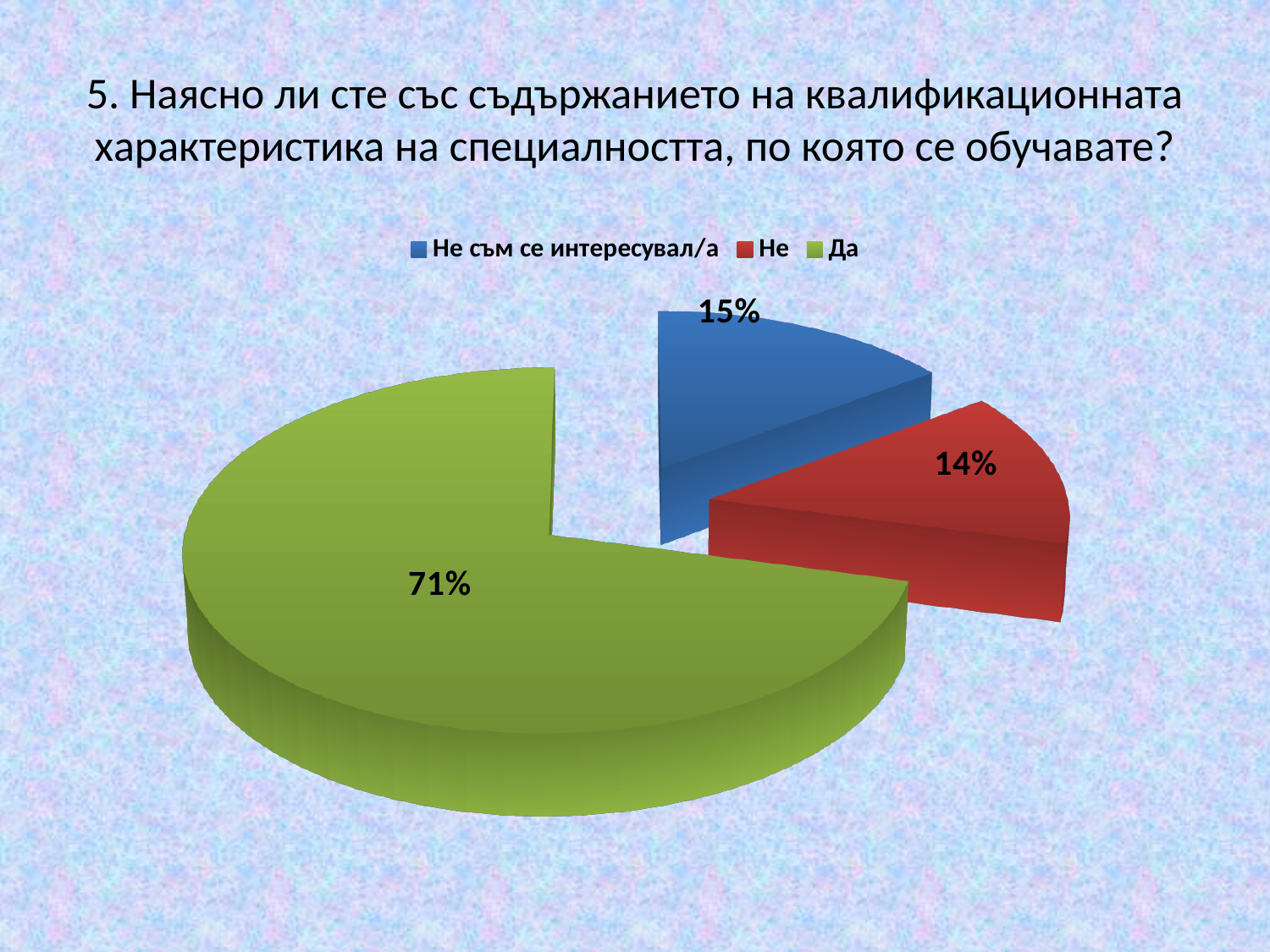
Which category has the smallest slice of the pie? Не Which category has the largest slice of the pie? Да What is the difference in percentage points between "Да" and "Не"? 57 How many entries does the legend list? 3 How many slices does the pie chart have? 3 What is the difference in percentage points between "Не съм се интересувал/а" and "Не"? 1 Which colour represents "Не" in the pie chart? red What share of the pie does "Не съм се интересувал/а" represent? 15% What share of the pie does "Да" represent? 71% Which colour represents "Да" in the pie chart? green What share of the pie does "Не" represent? 14% What kind of chart is shown on the slide? pie chart